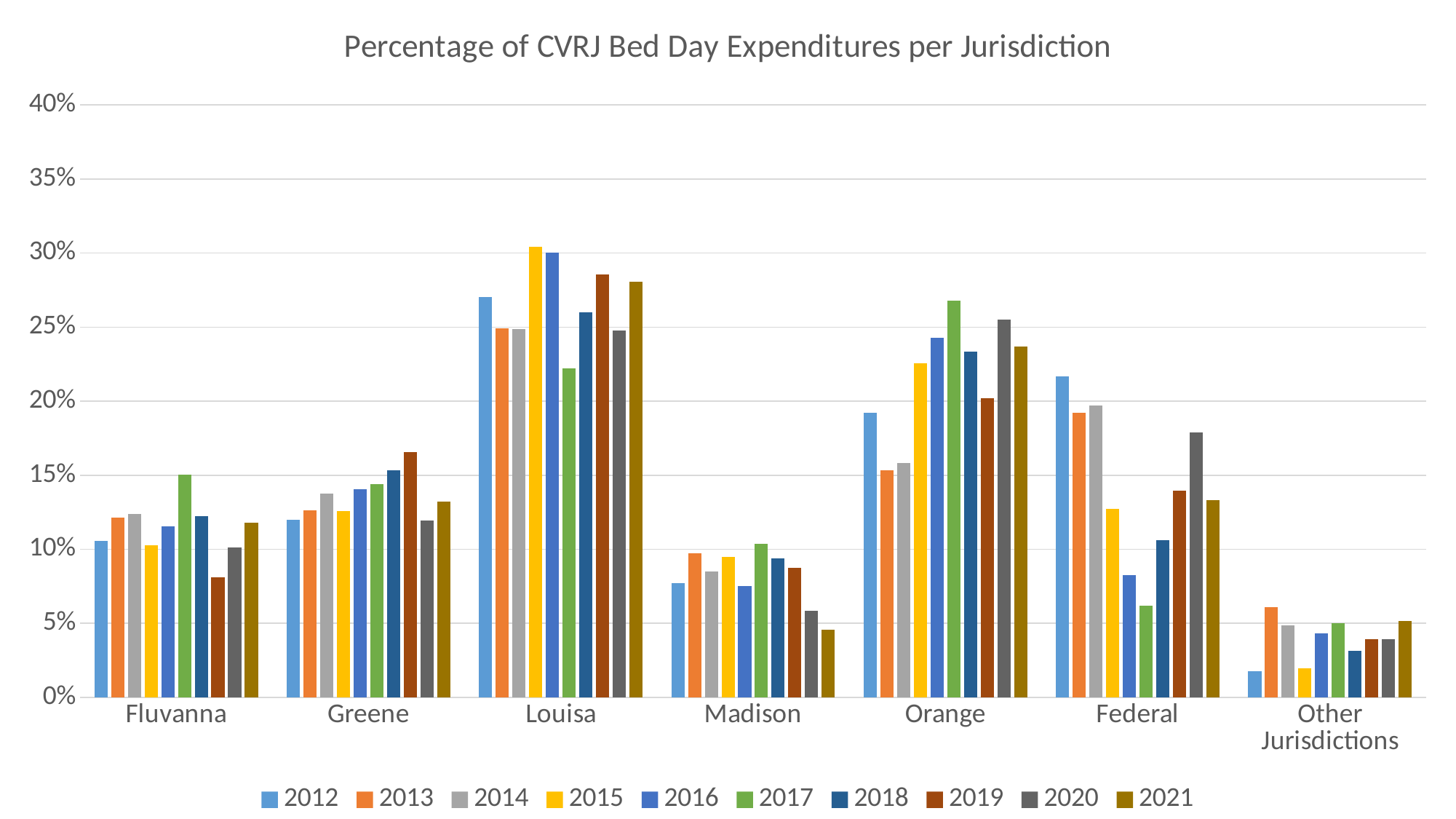
Is the value for Federal in 2012 greater or less than 20%? greater What is the title of the chart? Percentage of CVRJ Bed Day Expenditures per Jurisdiction Which year has the lowest bar for Federal? 2017 How many series (years) does the legend list? 10 What kind of chart is shown on the slide? Bar chart Is the value for Madison in 2021 greater or less than 5%? less Which year has the highest bar for Orange? 2017 How many jurisdiction categories are shown on the x axis? 7 Which jurisdiction has the highest bar for 2015? Louisa Which year has the lowest bar for Fluvanna? 2019 Is the value for Louisa in 2012 greater or less than 25%? greater Which is larger for Federal: the 2019 value or the 2020 value? 2020